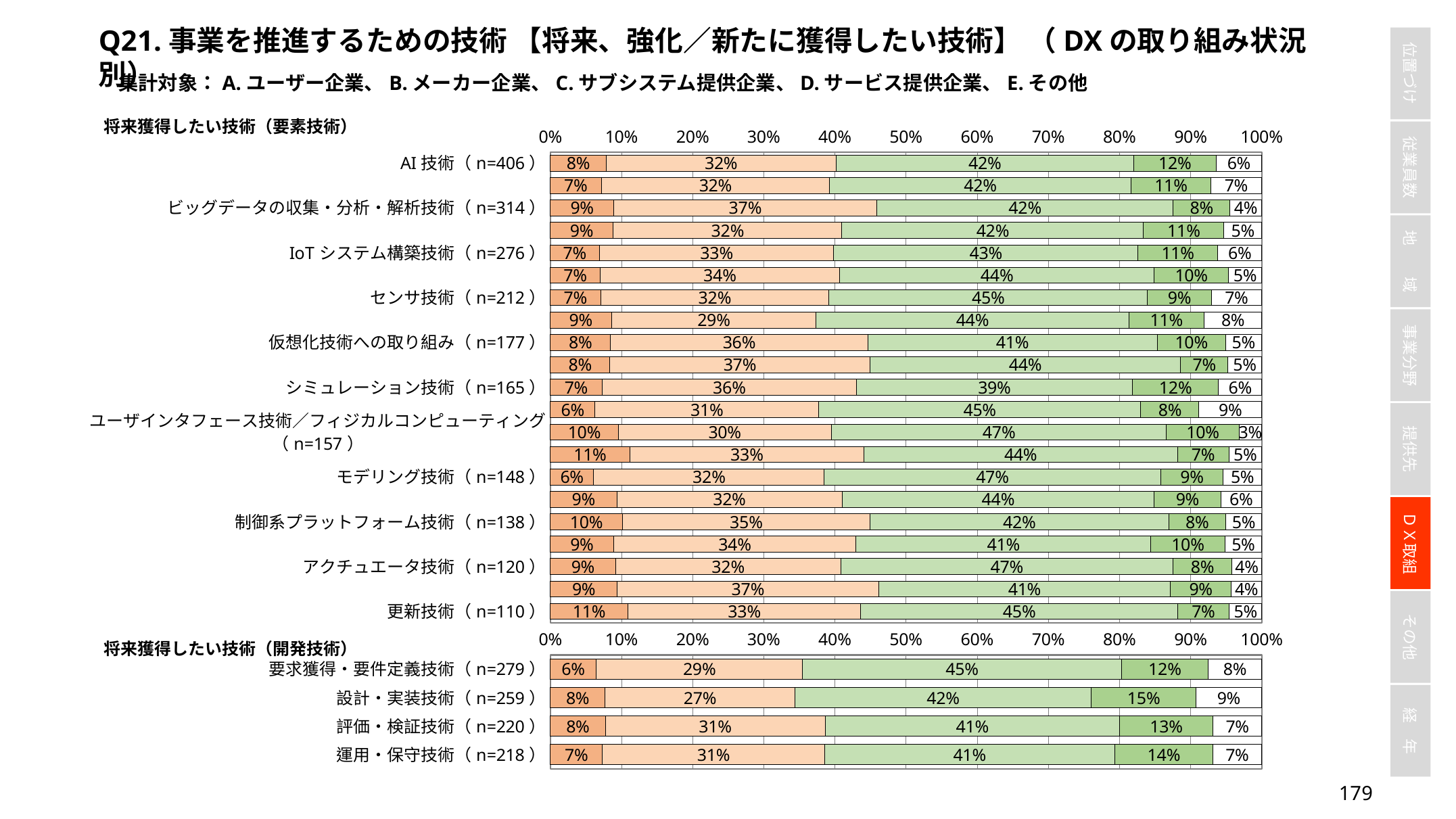
In the bottom chart (開発技術), what is the value of the dark green (fourth) segment for 要求獲得・要件定義技術? 12% How many categories are shown in the bottom chart titled 将来獲得したい技術（開発技術）? 4 In the bottom chart (開発技術), which category has the largest dark green (fourth) segment? 設計・実装技術 In the bottom chart (開発技術), what is the sample size (n) shown for 運用・保守技術? 218 In the bottom chart (開発技術), what is the total of all segments in the bar for 要求獲得・要件定義技術? 100% What kind of chart is the bottom chart titled 将来獲得したい技術（開発技術）? Stacked bar chart In the bottom chart (開発技術), which category has the smallest light orange (second) segment? 設計・実装技術 How many categories are listed in the top chart titled 将来獲得したい技術（要素技術）? 21 In the bottom chart (開発技術), what is the difference between the dark green segment of 設計・実装技術 and that of 要求獲得・要件定義技術? 3 percentage points In the bottom chart (開発技術), what is the value of the white (last) segment for 設計・実装技術? 9% In the bottom chart (開発技術), which has the larger light orange (second) segment: 要求獲得・要件定義技術 or 設計・実装技術? 要求獲得・要件定義技術 In the bottom chart (開発技術), what is the value of the light green (third) segment for 設計・実装技術? 42%